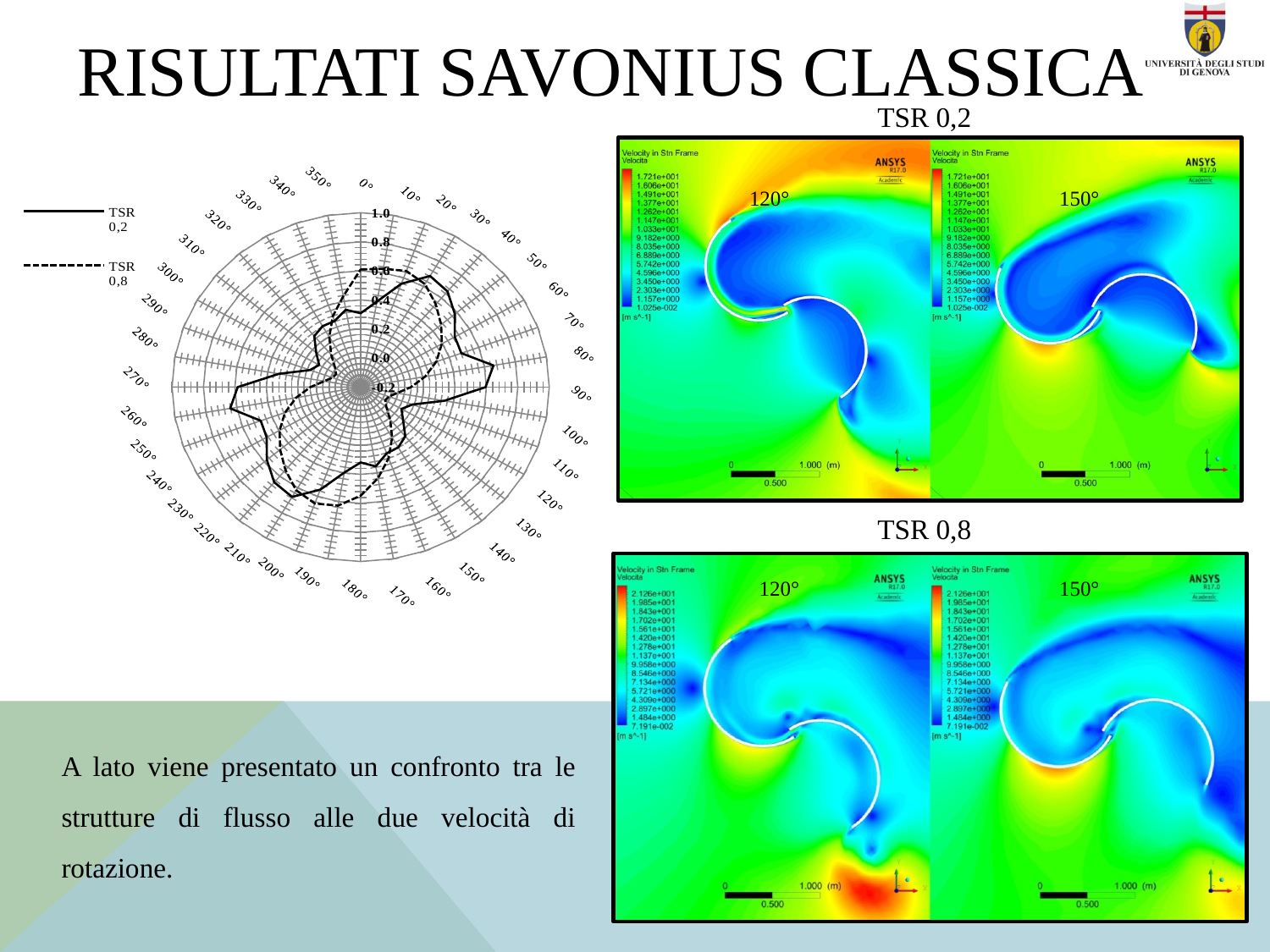
In the polar chart, is the value for TSR 0,2 at 90° greater or less than 0.2? greater In the polar chart, is the value for TSR 0,8 at 180° greater or less than 0.2? greater In the polar chart, which line style represents TSR 0,8? Dashed How many angular categories (in 10° steps) are labelled around the polar chart? 36 In the polar chart, is the value for TSR 0,8 at 90° greater or less than 0.6? less What is the maximum value shown on the radial axis of the polar chart? 1.0 How many series does the legend of the polar chart list? 2 What is the minimum value shown on the radial axis of the polar chart? -0.2 What kind of chart is shown on the left of the slide? Polar (radar) chart Which two series are listed in the legend of the polar chart? TSR 0,2 and TSR 0,8 In the polar chart, which series has the larger value at 270°, TSR 0,2 or TSR 0,8? TSR 0,2